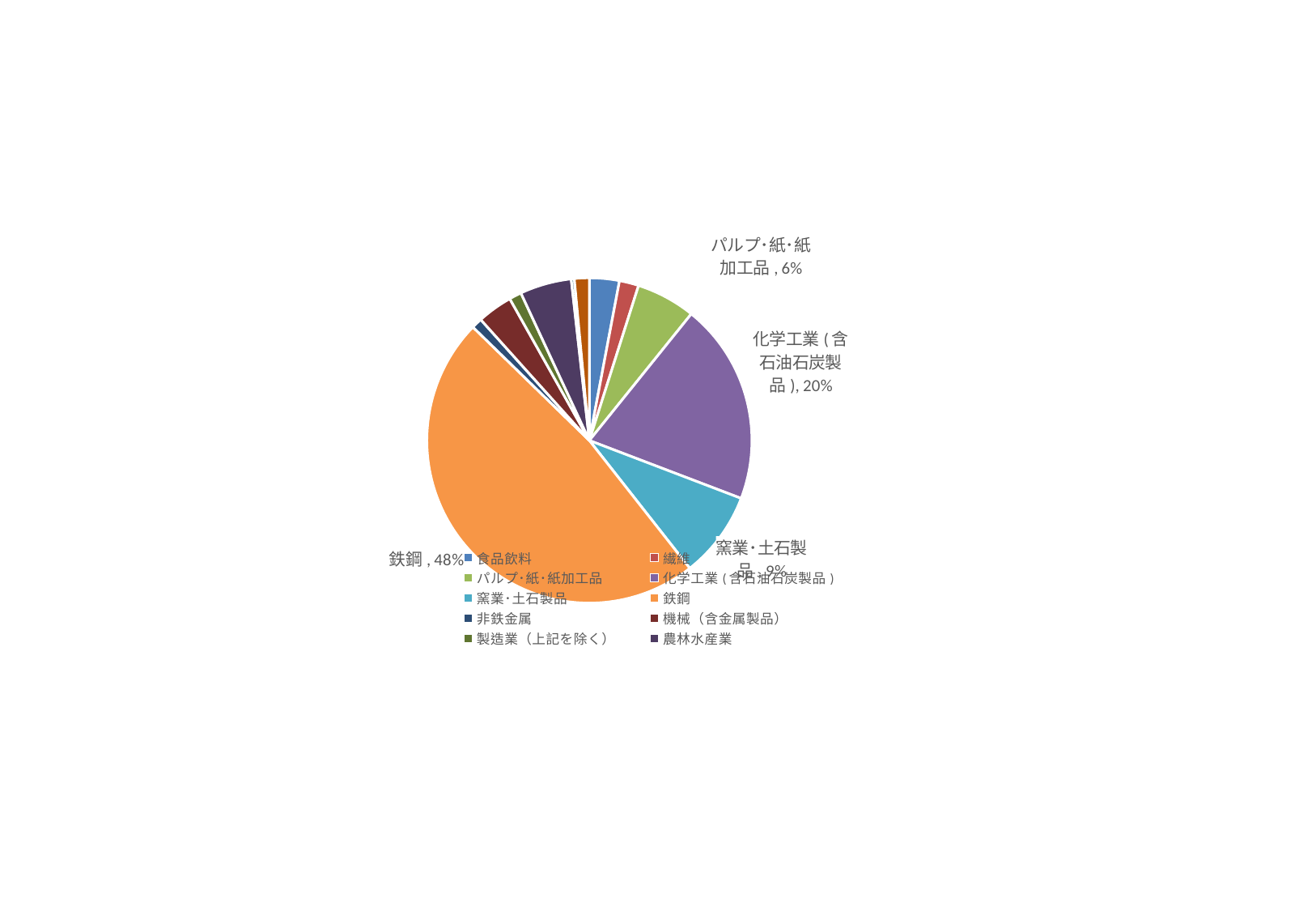
What type of chart is shown on the slide? Pie chart Which category has the largest slice of the pie? 鉄鋼 What share of the pie does 鉄鋼 account for? 48% What percentage is labelled for 窯業・土石製品? 9% How many categories does the legend list? 10 Which is larger, the slice for 窯業・土石製品 or the slice for パルプ・紙・紙加工品? 窯業・土石製品 What colour is the 鉄鋼 slice? Orange Which is larger, the slice for 化学工業 ( 含石油石炭製品 ) or the slice for パルプ・紙・紙加工品? 化学工業 ( 含石油石炭製品 ) What percentage is shown for 化学工業 ( 含石油石炭製品 )? 20% By how many percentage points does 鉄鋼 exceed 化学工業 ( 含石油石炭製品 )? 28 percentage points What is the combined share of 鉄鋼 and 化学工業 ( 含石油石炭製品 )? 68% What percentage is labelled for パルプ・紙・紙加工品? 6%